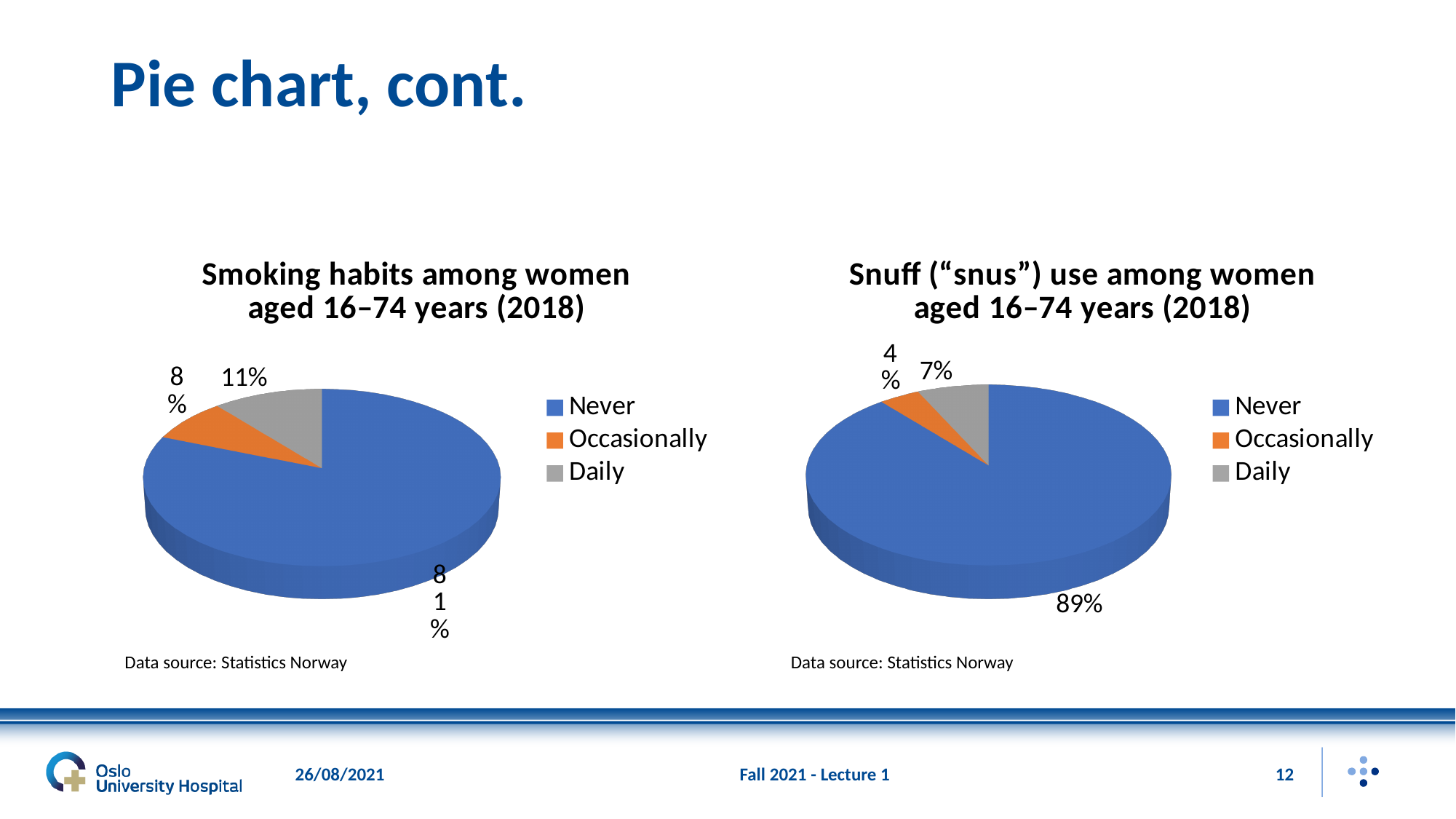
What type of chart is used for 'Smoking habits among women aged 16–74 years (2018)'? Pie chart In the 'Smoking habits among women aged 16–74 years (2018)' chart, what percentage of women never smoke? 81% In the 'Snuff ("snus") use among women aged 16–74 years (2018)' chart, what percentage of women never use snuff? 89% How many series does the legend of the 'Snuff ("snus") use among women aged 16–74 years (2018)' chart list? 3 In the 'Snuff ("snus") use among women aged 16–74 years (2018)' chart, what percentage of women use snuff daily? 7% In the 'Smoking habits among women aged 16–74 years (2018)' chart, what percentage of women smoke daily? 11% In the 'Smoking habits among women aged 16–74 years (2018)' chart, what percentage of women smoke occasionally? 8% In the 'Smoking habits among women aged 16–74 years (2018)' chart, what is the difference in percentage points between Daily and Occasionally? 3 In the 'Snuff ("snus") use among women aged 16–74 years (2018)' chart, what percentage of women use snuff occasionally? 4% In the 'Snuff ("snus") use among women aged 16–74 years (2018)' chart, which category has the largest slice? Never Which is larger: the Daily share in the smoking chart or the Daily share in the snuff chart? Daily share in the smoking chart In the 'Smoking habits among women aged 16–74 years (2018)' chart, which category has the smallest slice? Occasionally